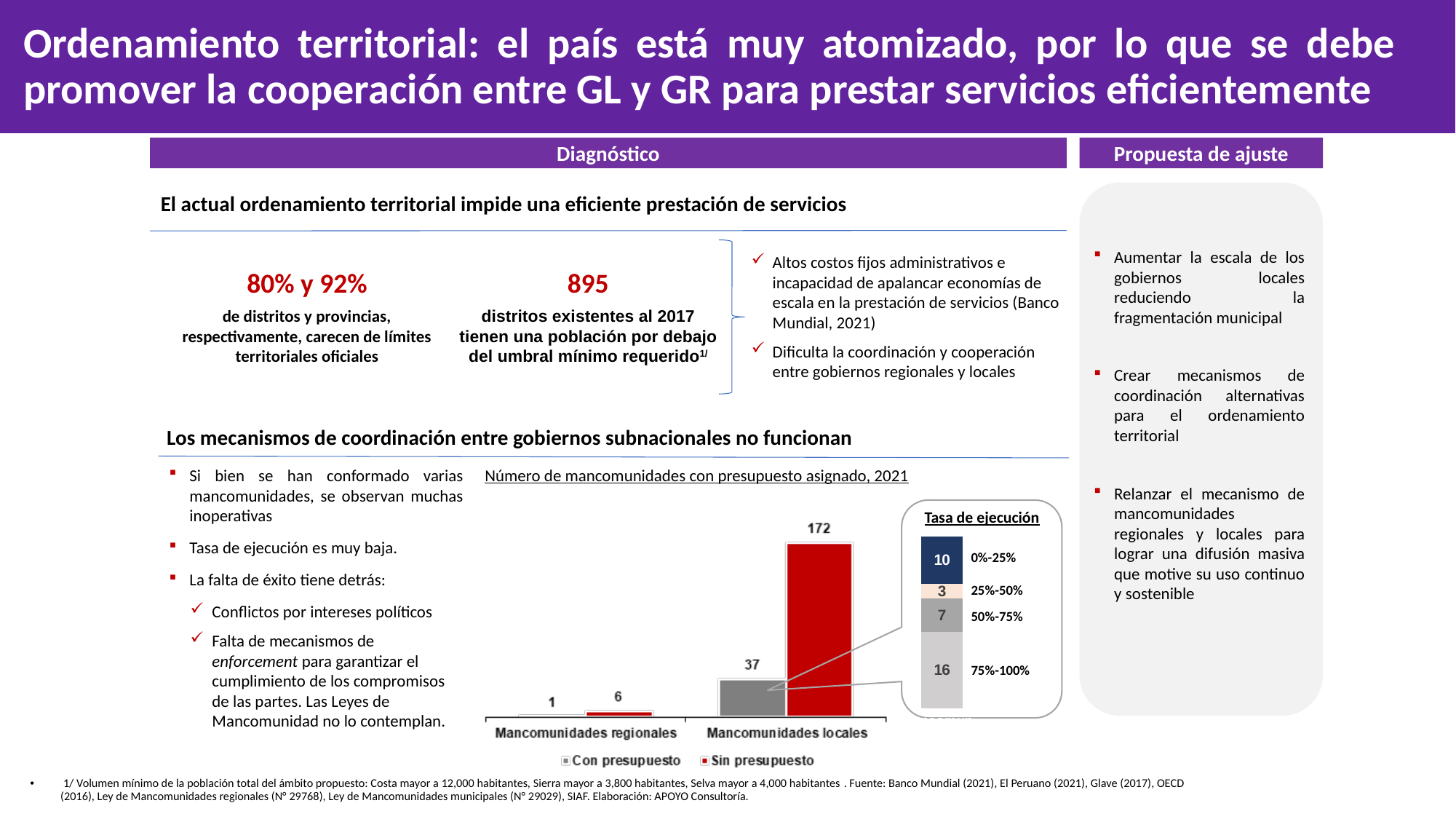
In the chart 'Número de mancomunidades con presupuesto asignado, 2021', what is the value of 'Sin presupuesto' for Mancomunidades regionales? 6 In the chart 'Número de mancomunidades con presupuesto asignado, 2021', what is the value of 'Con presupuesto' for Mancomunidades locales? 37 What type of chart is 'Número de mancomunidades con presupuesto asignado, 2021'? Bar chart In the chart 'Número de mancomunidades con presupuesto asignado, 2021', what is the value of 'Sin presupuesto' for Mancomunidades locales? 172 In the chart 'Número de mancomunidades con presupuesto asignado, 2021', how many series does the legend list? 2 In the chart 'Número de mancomunidades con presupuesto asignado, 2021', what is the value of 'Con presupuesto' for Mancomunidades regionales? 1 In the chart 'Número de mancomunidades con presupuesto asignado, 2021', how many categories are shown on the x axis? 2 In the 'Tasa de ejecución' stacked bar next to the chart, which segment has the lowest value? 25%-50% In the chart 'Número de mancomunidades con presupuesto asignado, 2021', which bar is the highest? Sin presupuesto, Mancomunidades locales In the 'Tasa de ejecución' stacked bar next to the chart, what is the value for the 75%-100% segment? 16 In the chart 'Número de mancomunidades con presupuesto asignado, 2021', what is the difference between 'Sin presupuesto' and 'Con presupuesto' for Mancomunidades locales? 135 In the chart 'Número de mancomunidades con presupuesto asignado, 2021', which is larger for Mancomunidades regionales: 'Con presupuesto' or 'Sin presupuesto'? Sin presupuesto